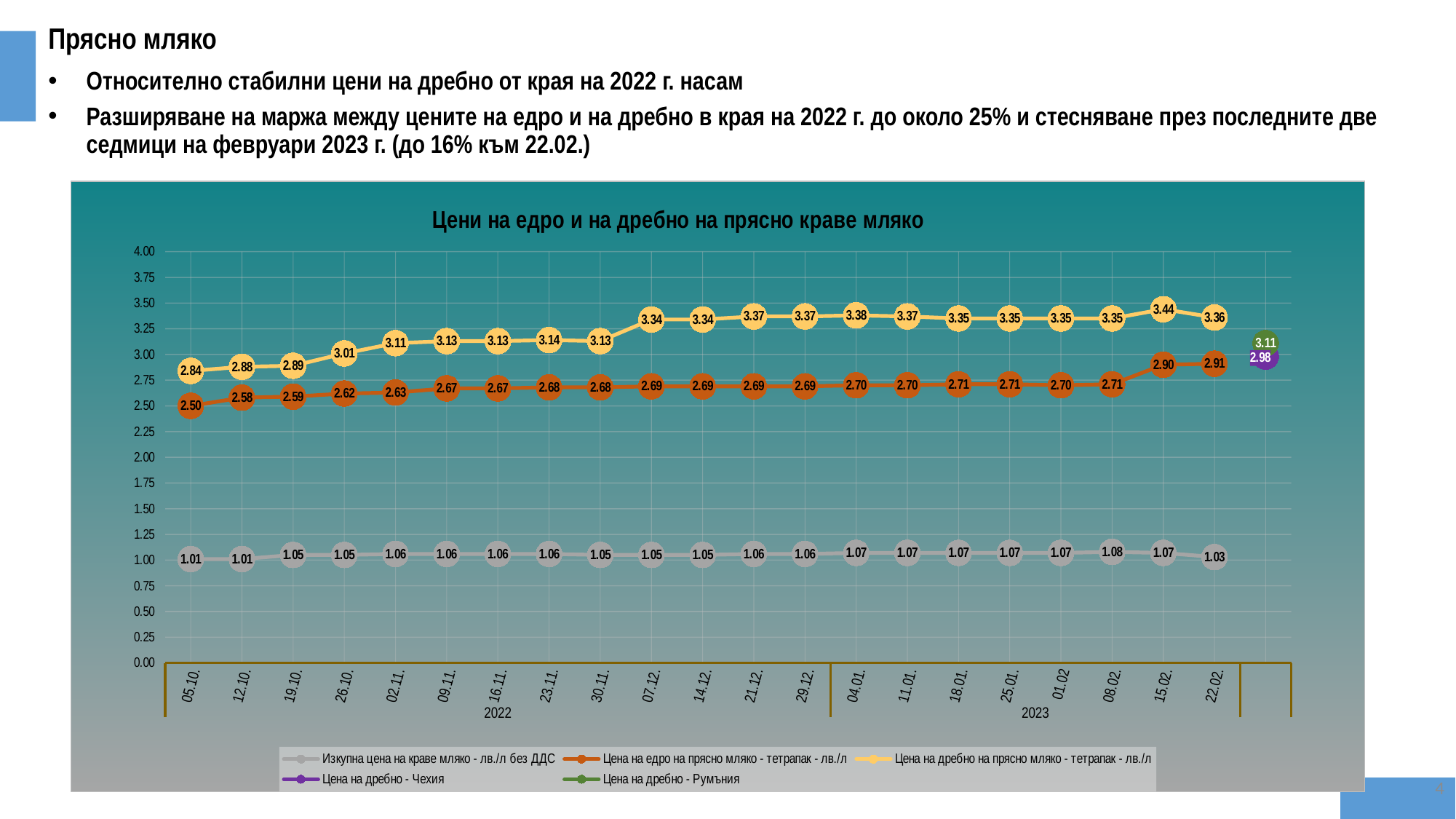
How many series does the legend list? 5 Does the wholesale price (Цена на едро) generally rise or fall from 05.10.2022 to 22.02.2023? Rise What is the purchase price (Изкупна цена на краве мляко) on 08.02.2023? 1.08 On which date does the retail price (Цена на дребно на прясно мляко - тетрапак) reach its highest value? 15.02.2023 What is the wholesale price (Цена на едро на прясно мляко - тетрапак) on 05.10.2022? 2.50 What is the lowest value of the wholesale price series (Цена на едро на прясно мляко - тетрапак)? 2.50 Which is higher: the retail price in Romania (Цена на дребно - Румъния) or in the Czech Republic (Цена на дребно - Чехия)? Румъния (3.11) What is the difference between the retail price and the wholesale price on 22.02.2023? 0.45 How many dates are shown on the x axis? 21 What type of chart is shown on the slide? Line chart What is the retail price (Цена на дребно на прясно мляко - тетрапак) on 22.02.2023? 3.36 What is the title of the chart? Цени на едро и на дребно на прясно краве мляко